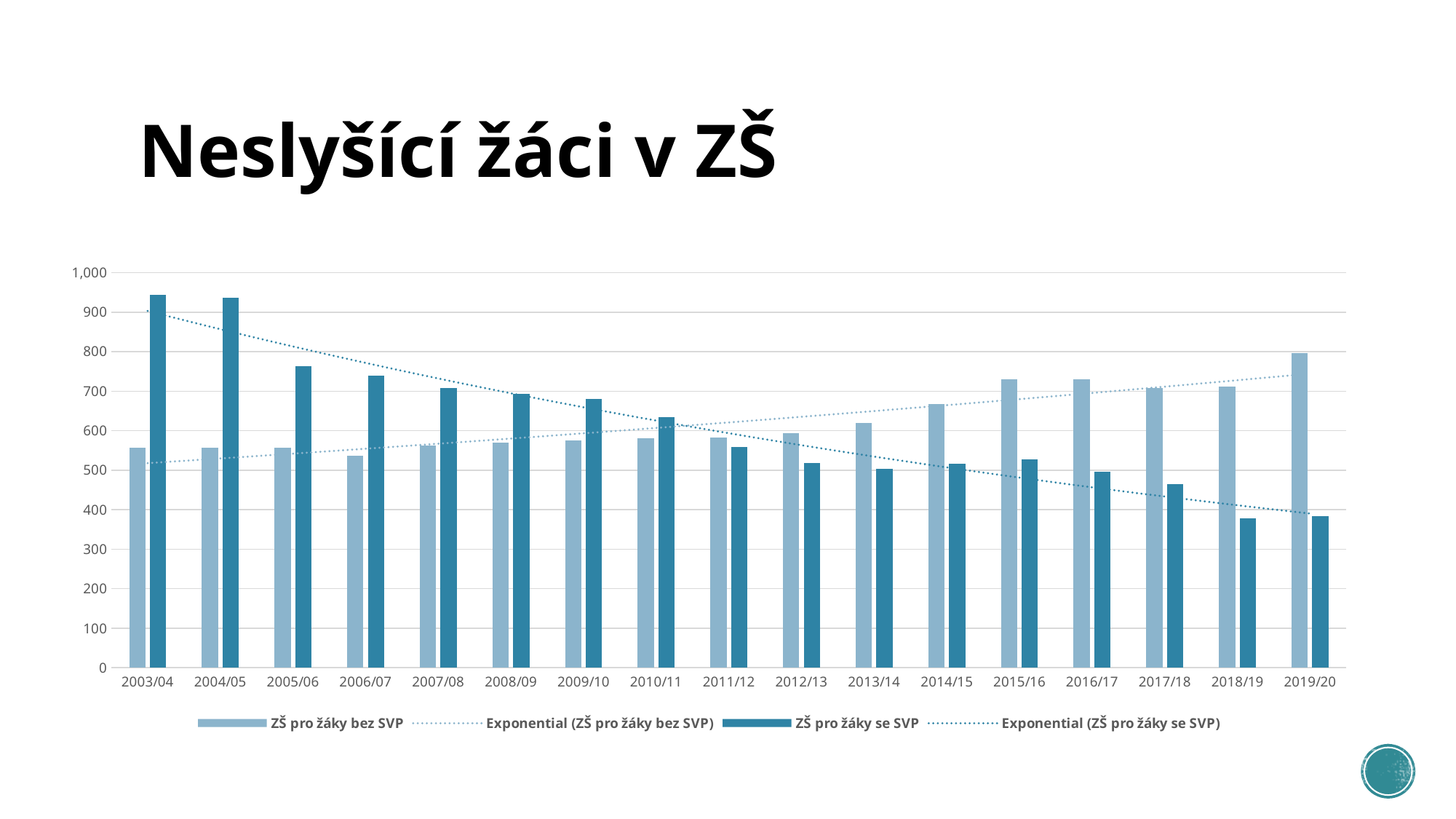
How many entries does the legend list? 4 Do the values for ZŠ pro žáky se SVP generally rise or fall from 2003/04 to 2019/20? fall In which school year is the value for ZŠ pro žáky bez SVP lowest? 2006/07 In 2003/04, which series has the larger value: ZŠ pro žáky bez SVP or ZŠ pro žáky se SVP? ZŠ pro žáky se SVP In which school year is the value for ZŠ pro žáky bez SVP highest? 2019/20 How many school years are shown on the x axis? 17 What kind of chart is shown on the slide? bar chart Is the value for ZŠ pro žáky se SVP in 2019/20 greater or less than 400? less Is the value for ZŠ pro žáky se SVP in 2003/04 greater or less than 900? greater Is the value for ZŠ pro žáky se SVP in 2010/11 greater or less than 600? greater What is the title of the slide containing the chart? Neslyšící žáci v ZŠ